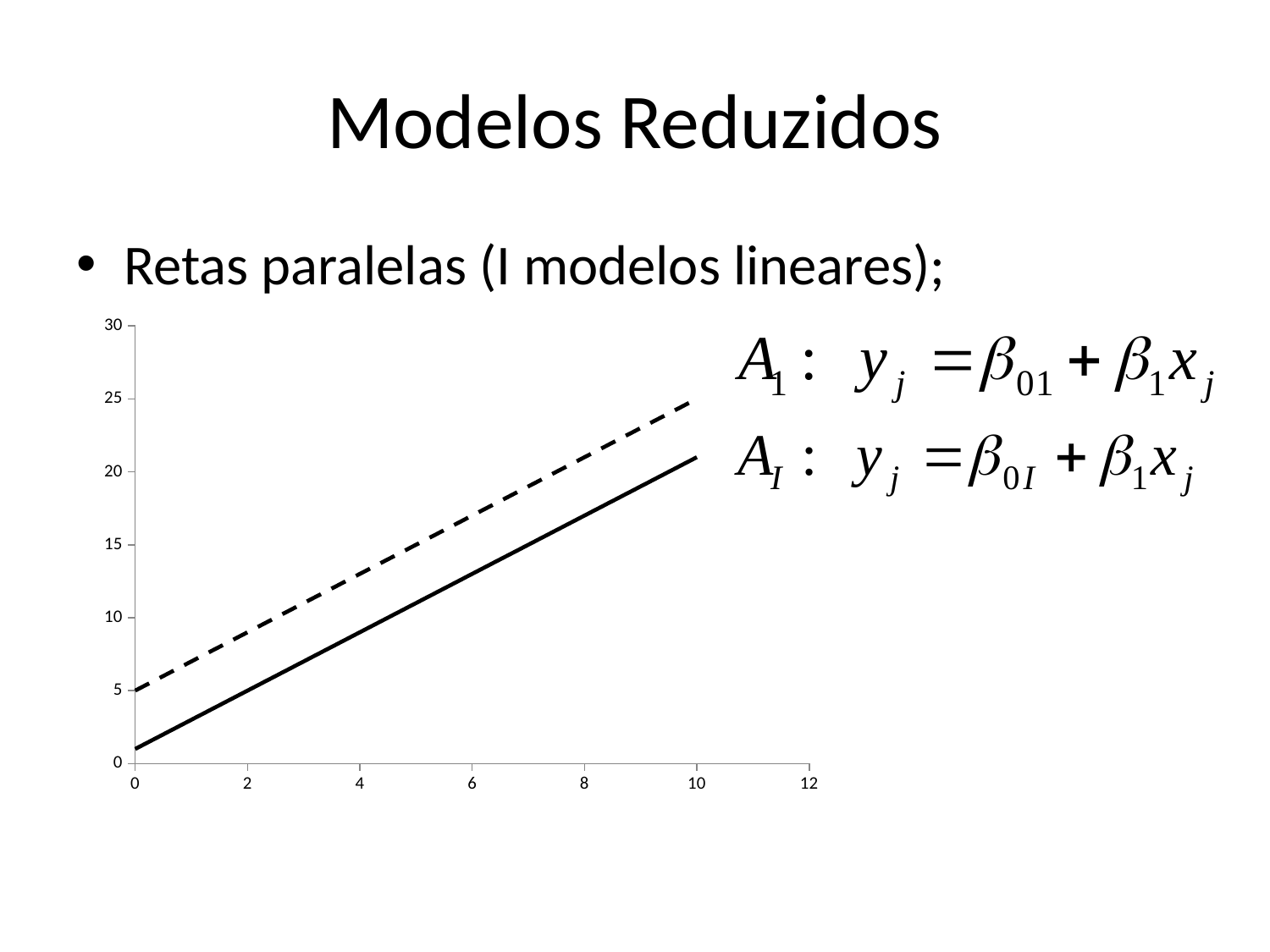
What is the highest tick value shown on the x axis? 12 What is the highest tick value shown on the y axis? 30 Is the value of the dashed line at x = 0 greater or less than 10? less Is the value of the dashed line at x = 4 greater or less than 10? greater How many lines are plotted on the chart? 2 Is the value of the dashed line at x = 10 greater or less than 20? greater Do the plotted lines rise or fall as x increases? rise What kind of chart is shown on the slide? line chart Which line lies higher on the chart, the solid line or the dashed line? the dashed line